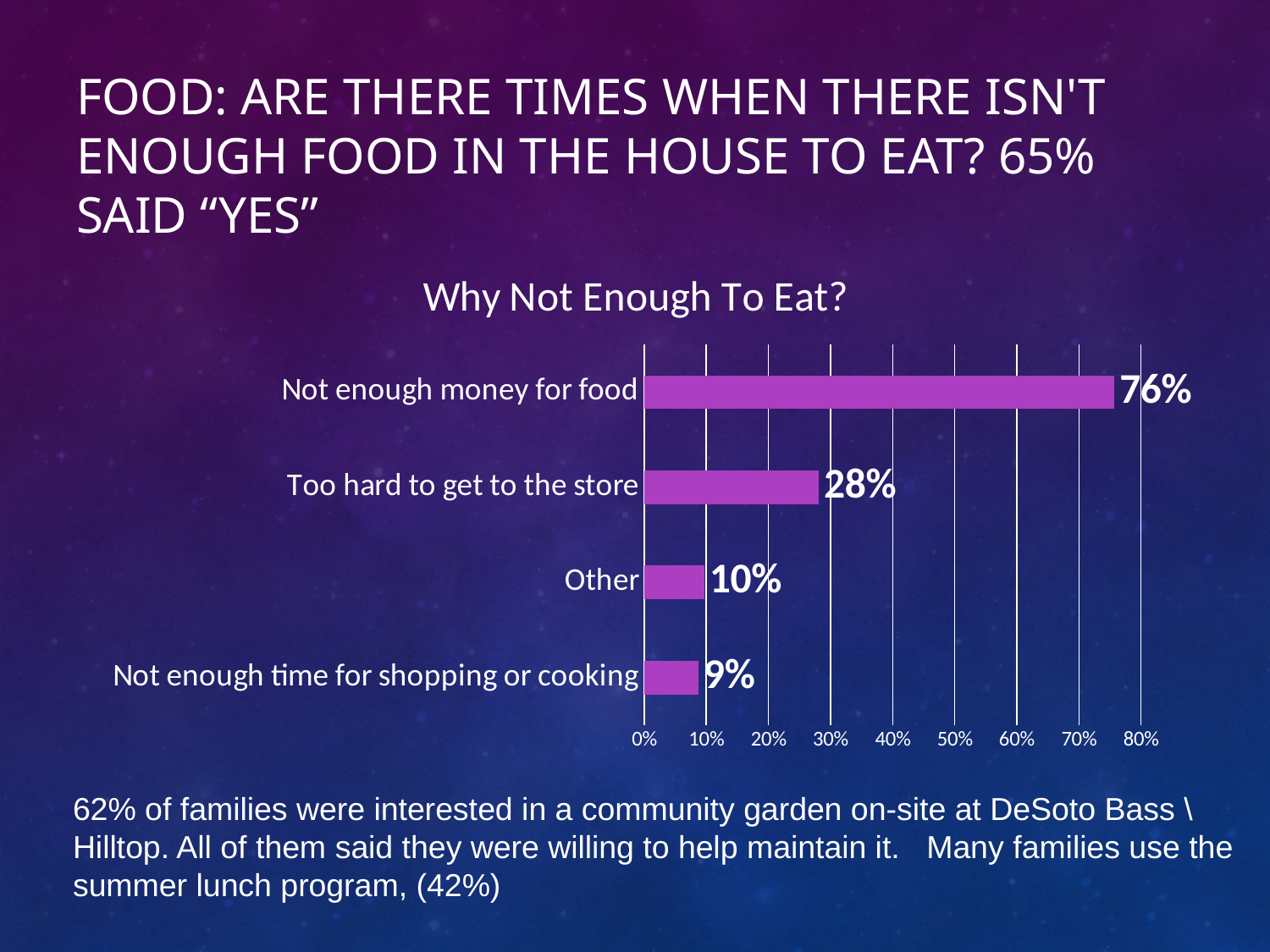
What percentage is shown for "Other"? 10% Which is larger: the value for "Too hard to get to the store" or the value for "Other"? Too hard to get to the store Which reason has the highest percentage? Not enough money for food What percentage is shown for "Not enough time for shopping or cooking"? 9% Is the value for "Not enough money for food" greater or less than 70%? greater How many reasons (categories) are shown in the chart? 4 What is the difference in percentage points between "Not enough money for food" and "Too hard to get to the store"? 48 What type of chart is used to show the reasons for not having enough to eat? Bar chart Which reason has the lowest percentage? Not enough time for shopping or cooking What percentage is shown for "Not enough money for food"? 76% What is the title of the chart? Why Not Enough To Eat? What percentage is shown for "Too hard to get to the store"? 28%